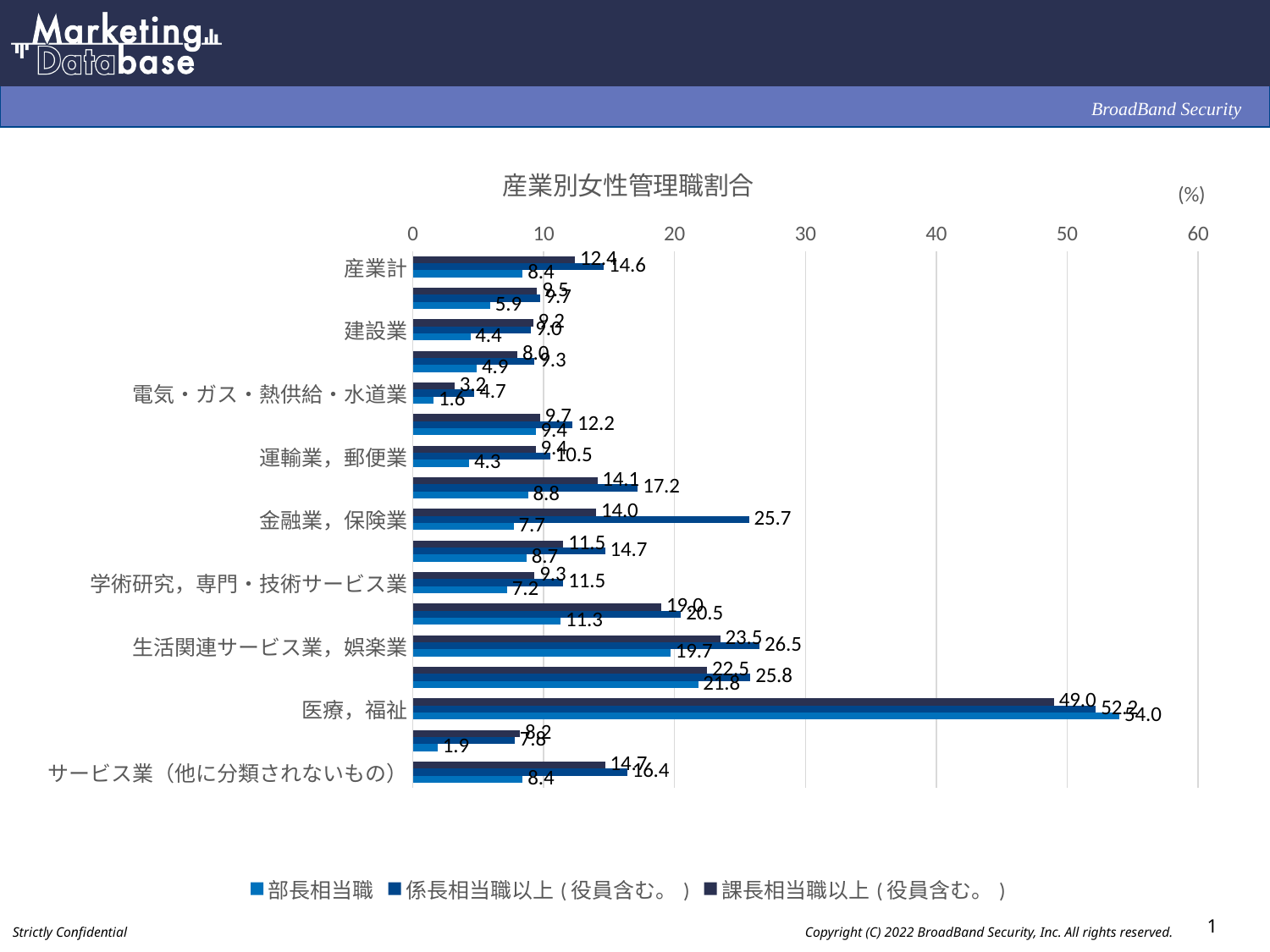
Is the 部長相当職 value for 医療，福祉 greater or less than 50? greater What is the difference between the 係長相当職以上 value and the 部長相当職 value for 金融業，保険業? 18.0 What is the 部長相当職 value for 産業計? 8.4 Which has the larger 係長相当職以上 value, 金融業，保険業 or 運輸業，郵便業? 金融業，保険業 What type of chart is shown on the slide? bar chart How many series does the legend list? 3 What is the 部長相当職 value for 電気・ガス・熱供給・水道業? 1.6 What is the 係長相当職以上 value for 医療，福祉? 52.2 Which labeled industry has the highest 部長相当職 value? 医療，福祉 What is the maximum value shown on the horizontal axis? 60 What is the title of the chart? 産業別女性管理職割合 What is the 係長相当職以上 value for 金融業，保険業? 25.7